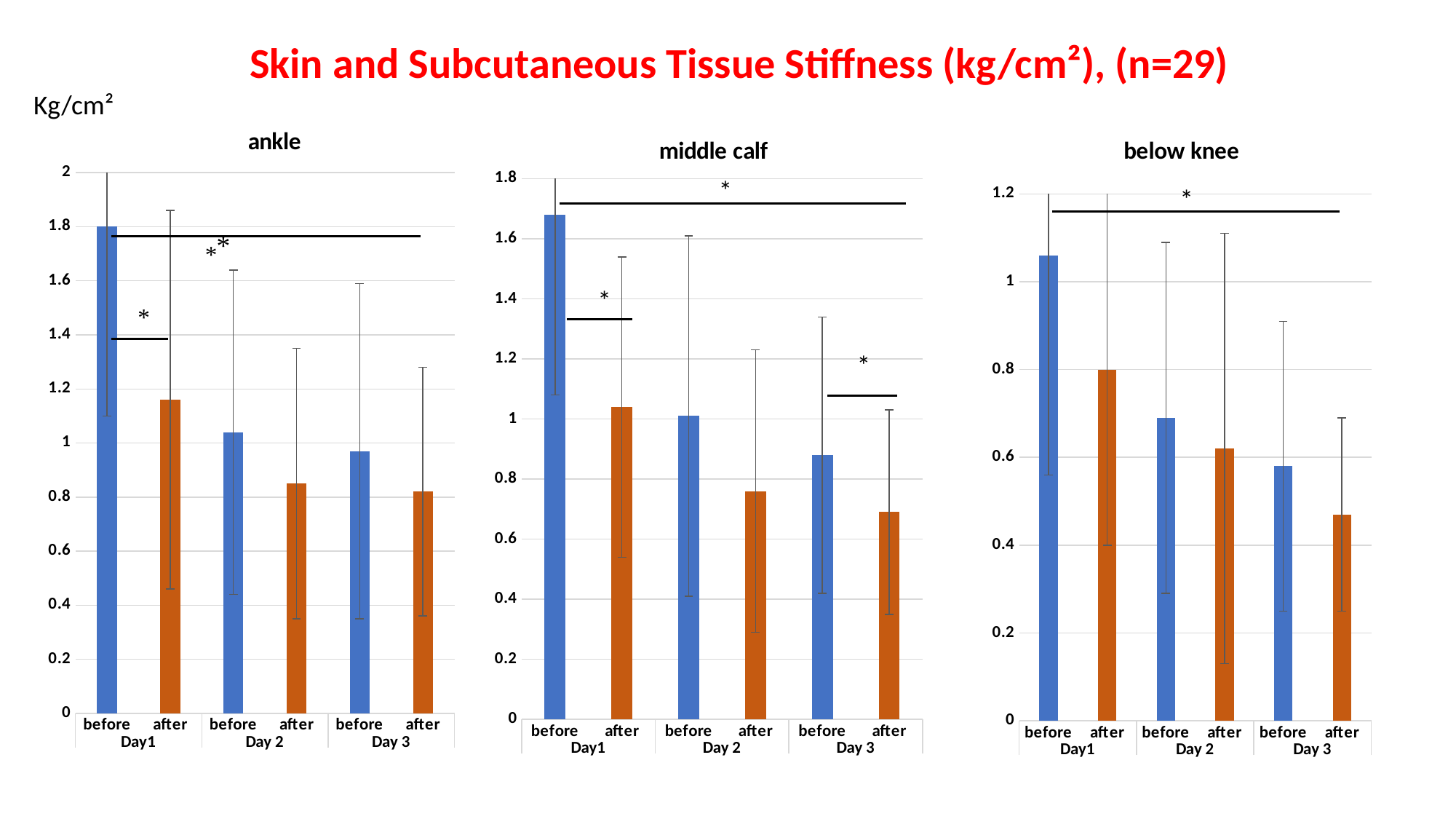
In the 'ankle' chart, do the 'before' values rise or fall from Day1 to Day 3? fall What kind of chart is the 'ankle' chart? bar chart In the 'below knee' chart, is the value for Day 3 after greater or less than 0.6? less In the 'middle calf' chart, is the value for Day1 before greater or less than 1.6? greater How many charts are shown on the slide? 3 In the 'middle calf' chart, what colour are the 'after' bars? orange In the 'ankle' chart, is the value for Day1 after greater or less than 1? greater In the 'middle calf' chart, which bar is the lowest? Day 3 after What is the title of the slide's chart group? Skin and Subcutaneous Tissue Stiffness (kg/cm²), (n=29) In the 'ankle' chart, how many bars are plotted? 6 In the 'ankle' chart, which bar is the highest? Day1 before In the 'below knee' chart, which is larger: Day1 before or Day 2 before? Day1 before